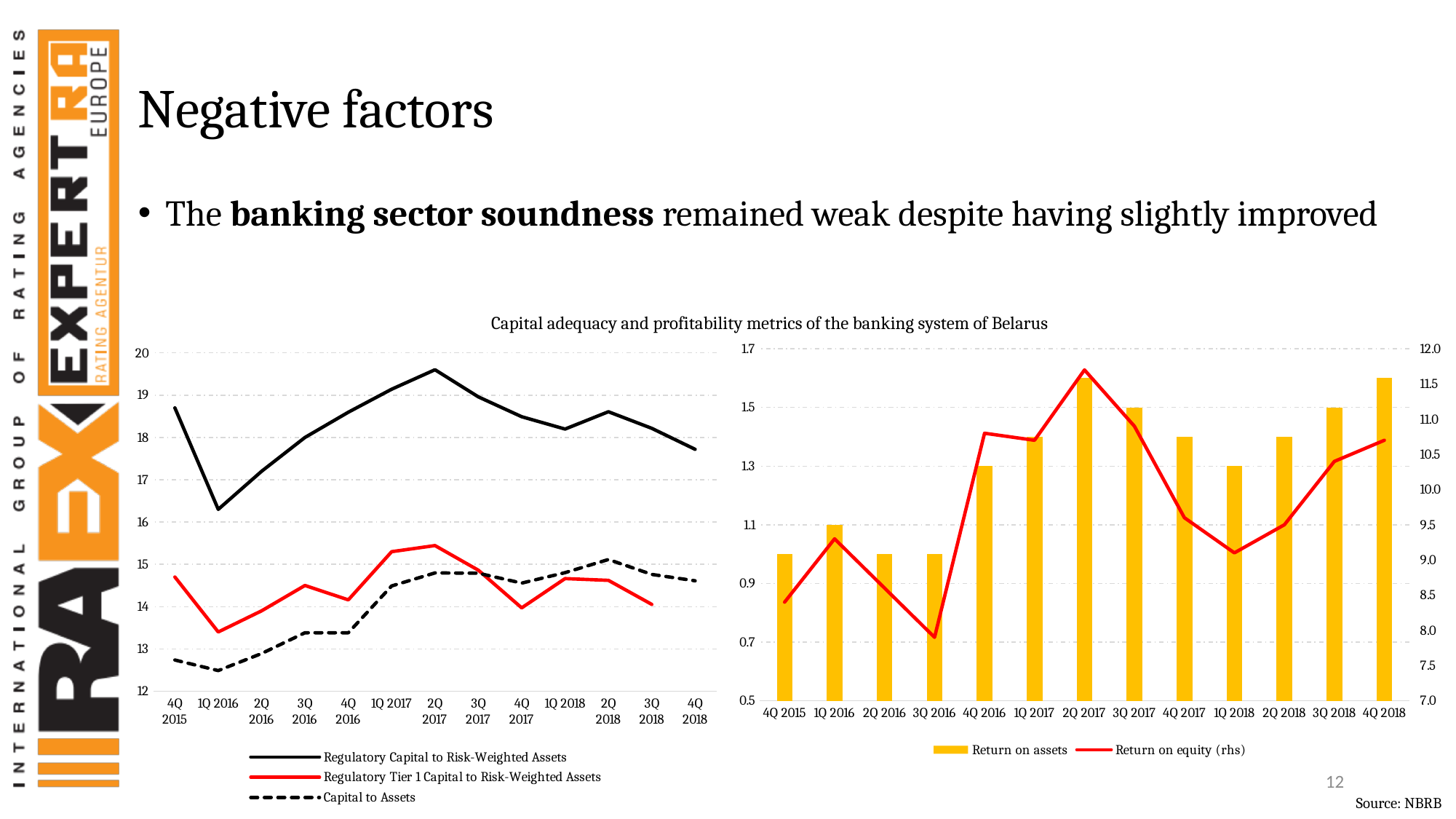
On the right chart, does Return on assets rise or fall from 3Q 2016 to 2Q 2017? Rise What kind of chart is the left chart? Line chart On the right chart, in which quarter is Return on equity (rhs) lowest? 3Q 2016 On the left chart, which is larger: Regulatory Capital to Risk-Weighted Assets in 4Q 2015 or in 4Q 2018? 4Q 2015 On the left chart, in which quarter is Regulatory Capital to Risk-Weighted Assets lowest? 1Q 2016 On the left chart, in which quarter is Regulatory Capital to Risk-Weighted Assets highest? 2Q 2017 On the right chart, in which quarter is Return on equity (rhs) highest? 2Q 2017 On the right chart, how many quarters are shown on the x axis? 13 On the right chart, how many series does the legend list? 2 On the left chart, how many series does the legend list? 3 On the right chart, is the Return on assets value for 2Q 2017 greater or less than 1.5? greater On the left chart, is the value of Regulatory Capital to Risk-Weighted Assets in 1Q 2016 greater or less than 17? less